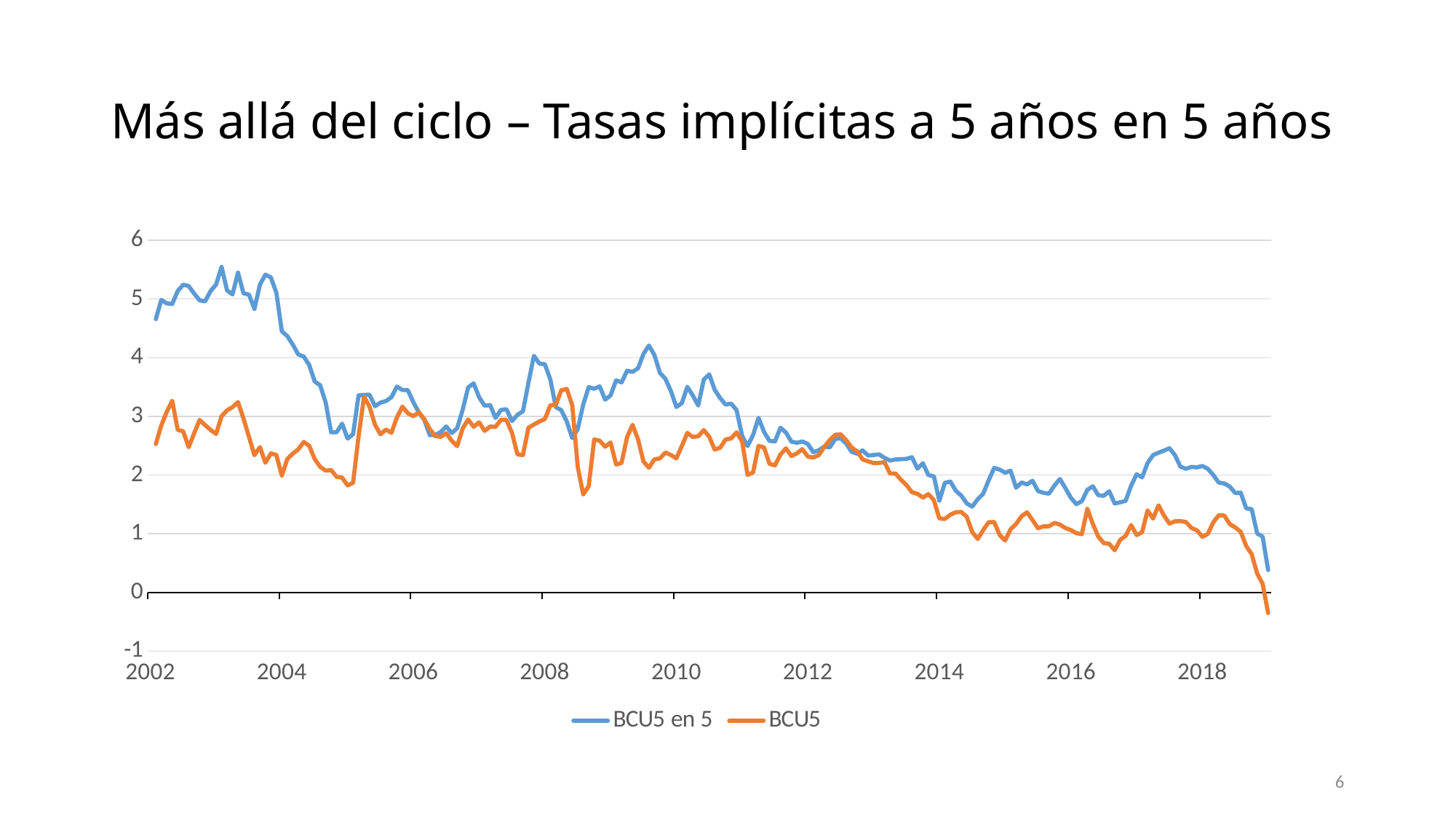
What are the names of the two series in the legend? BCU5 en 5 and BCU5 At the start of 2002, is the value for BCU5 greater or less than 2? greater At the start of 2002, which series has the higher value, BCU5 en 5 or BCU5? BCU5 en 5 Which series reaches the highest value anywhere on the chart? BCU5 en 5 Over the whole period from 2002 to 2018, does the BCU5 series generally rise or fall? fall At the start of 2002, is the value for BCU5 en 5 greater or less than 4? greater How many series does the legend list? 2 At the very end of the series (after 2018), is the value for BCU5 en 5 greater or less than 1? less What kind of chart is shown on the slide? line chart What is the title of the slide containing the chart? Más allá del ciclo – Tasas implícitas a 5 años en 5 años Over the whole period from 2002 to 2018, does the BCU5 en 5 series generally rise or fall? fall